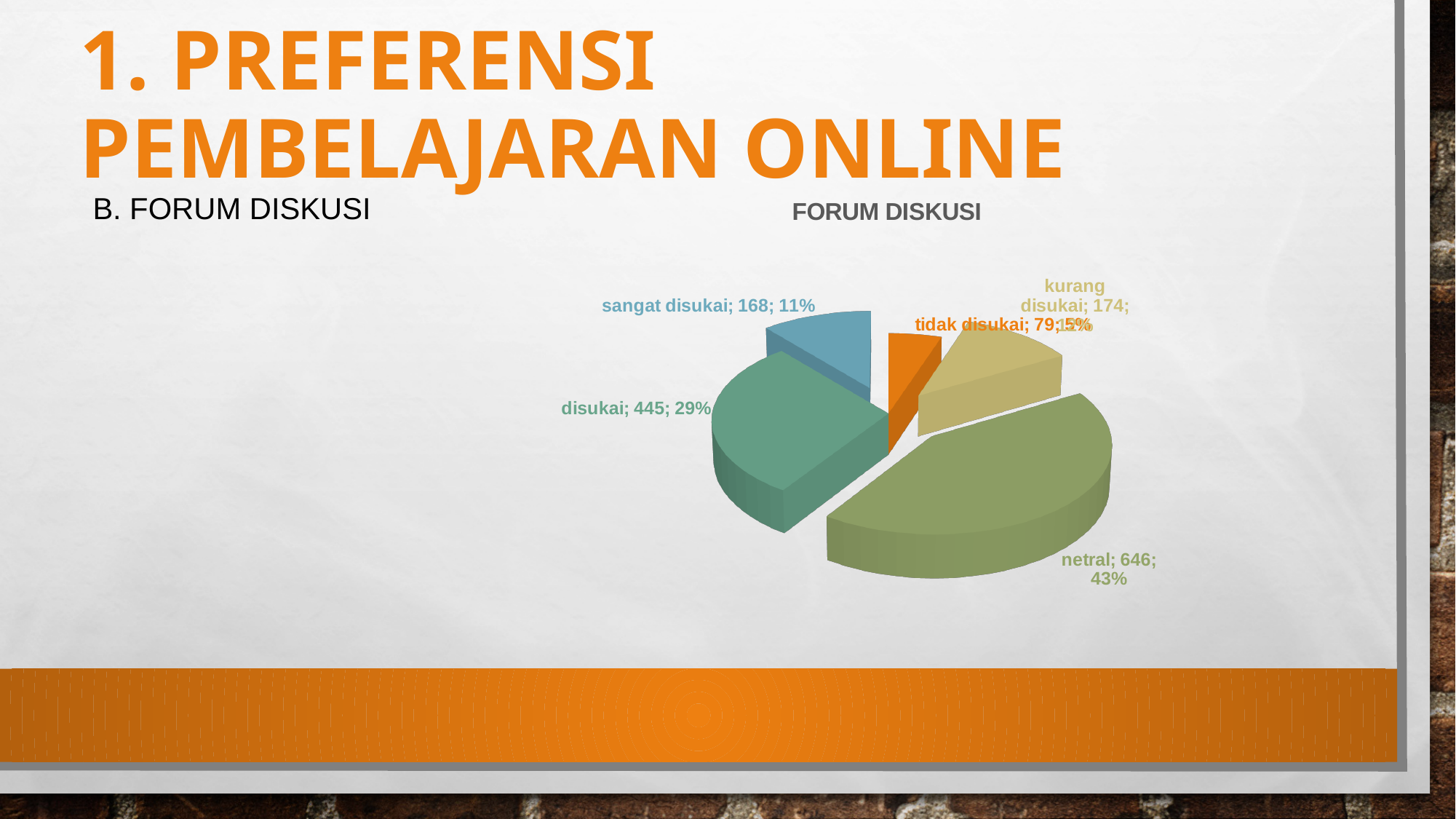
What share of the pie does 'netral' represent? 43% Which category has the largest slice? netral Which category has the smallest slice? tidak disukai What is the value for 'disukai'? 445 What is the value for 'kurang disukai'? 174 What is the value for 'netral'? 646 What is the value for 'tidak disukai'? 79 What kind of chart is shown on the slide? Pie chart How many slices does the pie chart have? 5 What is the title of the chart? FORUM DISKUSI What is the value for 'sangat disukai'? 168 What is the difference between the values for 'netral' and 'disukai'? 201